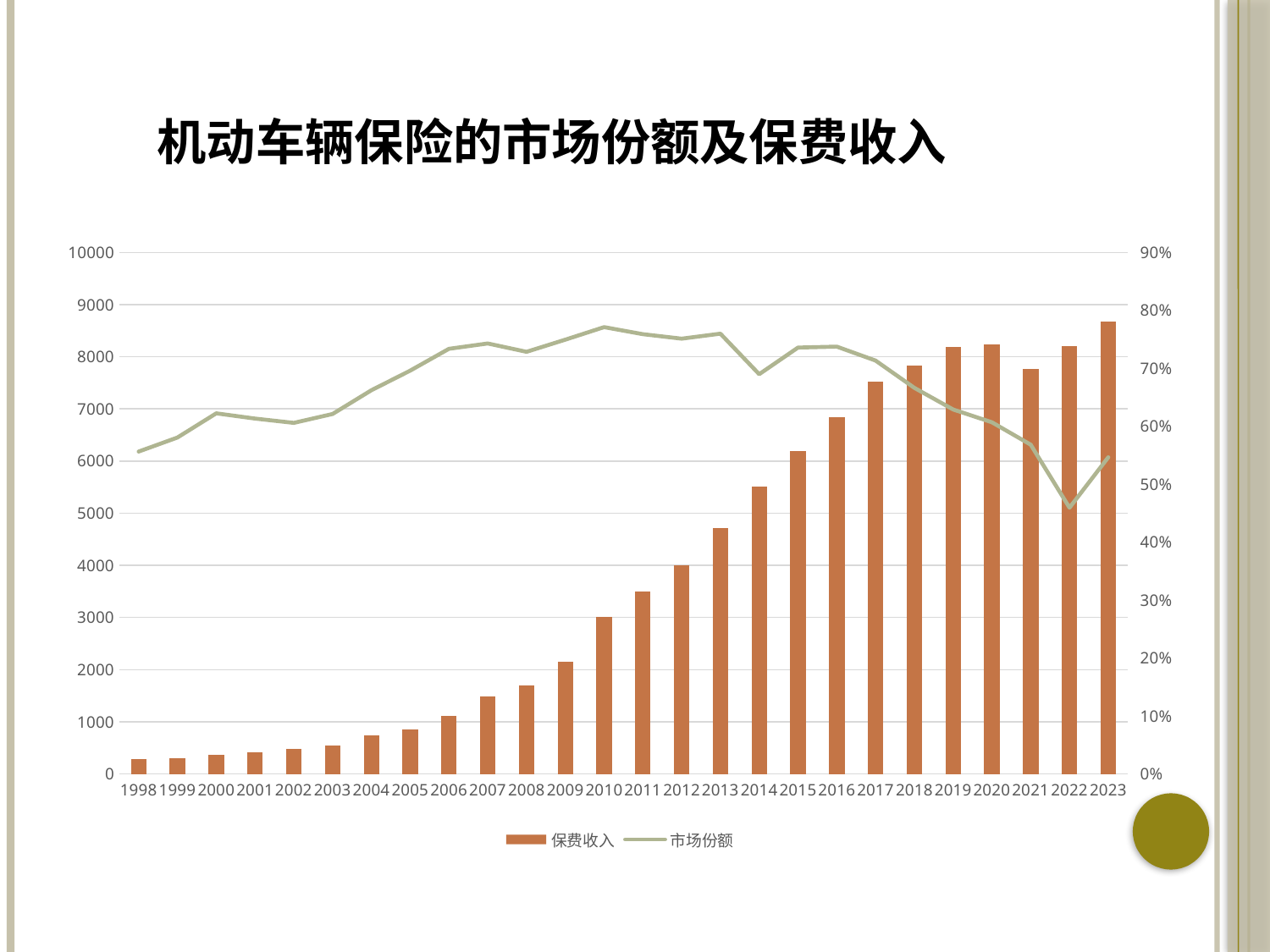
Which year has the larger 保费收入 bar, 2021 or 2022? 2022 What kind of chart is shown on the slide? A combination bar and line chart Is the 市场份额 value for 2022 greater or less than 50%? less How many series does the legend list? 2 Is the 市场份额 value for 1998 greater or less than 50%? greater Is the 保费收入 value for 2023 greater or less than 8000? greater In which year is the 市场份额 line at its lowest point? 2022 Does the 市场份额 line generally rise or fall from 2013 to 2022? fall How many years are shown on the x axis? 26 What are the two series named in the legend? 保费收入 and 市场份额 Which year has the highest 保费收入 bar? 2023